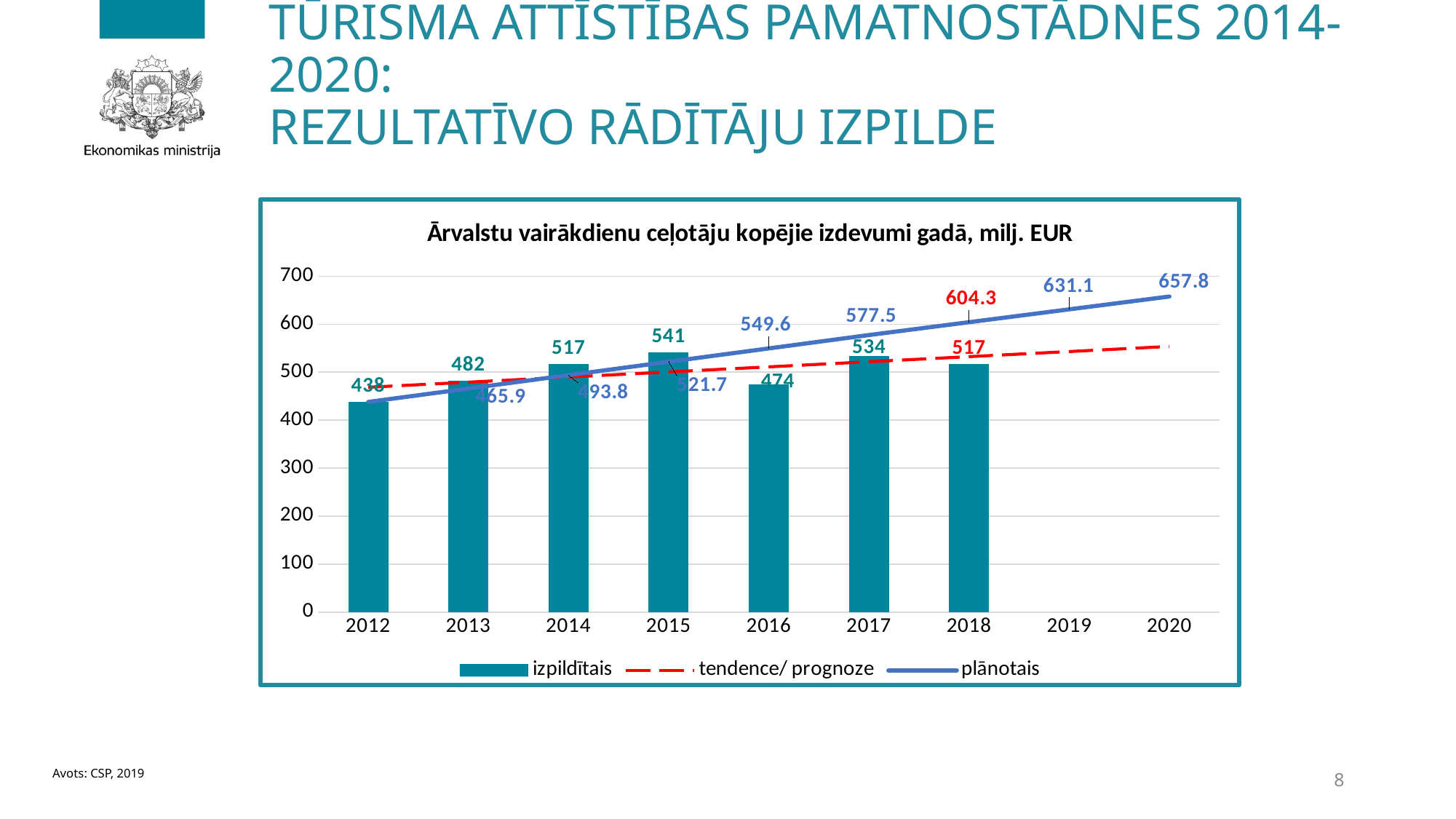
How many series does the legend list? 3 What is the plānotais value for 2019? 631.1 Which year has the lowest izpildītais bar? 2012 Which is larger, the izpildītais value for 2017 or for 2018? 2017 What is the title of the chart? Ārvalstu vairākdienu ceļotāju kopējie izdevumi gadā, milj. EUR Does the plānotais line rise or fall from 2012 to 2020? rise What is the difference between the izpildītais values for 2015 and 2016? 67 How many years are shown on the x axis? 9 What is the izpildītais value for 2016? 474 Which year has the highest izpildītais bar? 2015 What is the izpildītais value for 2015? 541 What is the plānotais value for 2020? 657.8